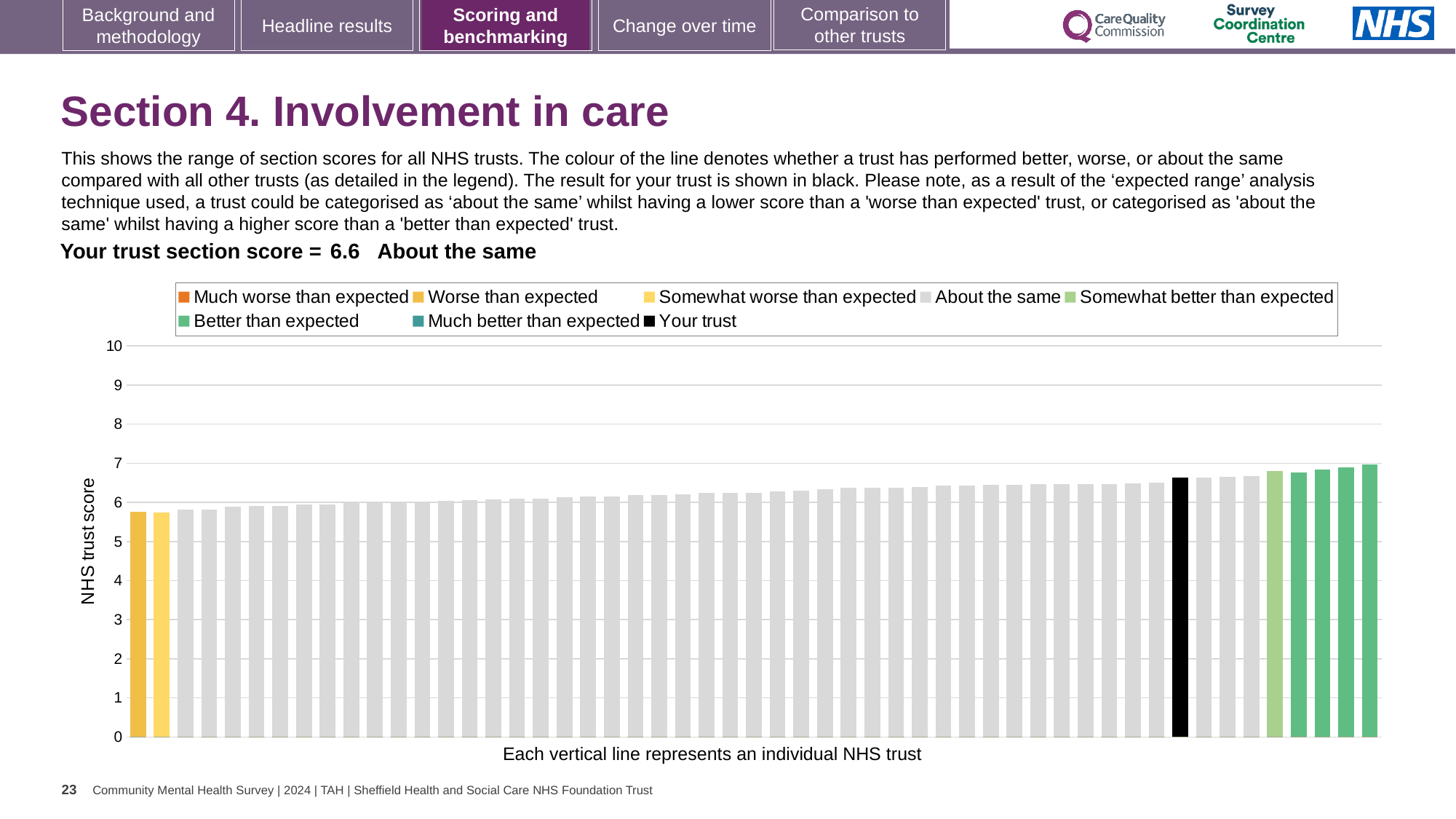
How many entries does the chart legend list? 8 Which performance category is your trust placed in for Section 4? About the same What colour is the bar representing your trust? black How many bars are coloured yellow (worse or somewhat worse than expected)? 2 Is the value of the leftmost bar greater or less than 6? less Is the value of the rightmost bar greater or less than 6? greater Is the value of the black 'Your trust' bar greater or less than 7? less Do the bar values rise or fall from left to right along the x axis? rise What kind of chart is shown on the slide? bar chart What is the section score for your trust shown on the slide? 6.6 What is the label on the vertical axis of the chart? NHS trust score